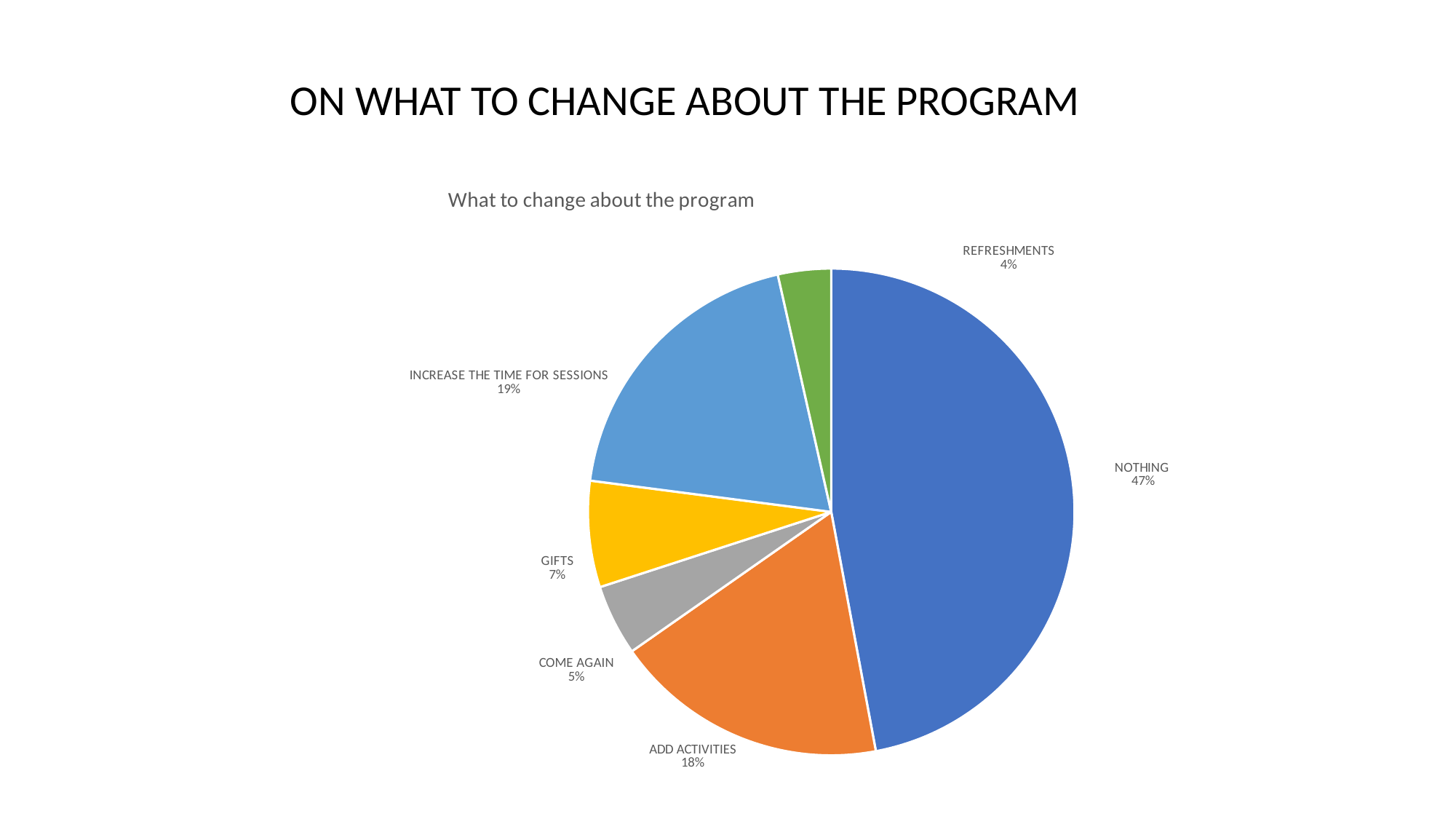
What percentage is shown for ADD ACTIVITIES? 18% What share of the pie is labelled NOTHING? 47% Which category has the smallest slice of the pie? REFRESHMENTS Which category has the largest slice of the pie? NOTHING What kind of chart is shown on the slide? pie chart What percentage is shown for INCREASE THE TIME FOR SESSIONS? 19% Which is larger, the share for GIFTS or the share for COME AGAIN? GIFTS What is the chart's title? What to change about the program What is the difference in percentage points between NOTHING and ADD ACTIVITIES? 29 What percentage is shown for REFRESHMENTS? 4% What colour is the slice for ADD ACTIVITIES? orange How many categories are shown in the pie chart? 6